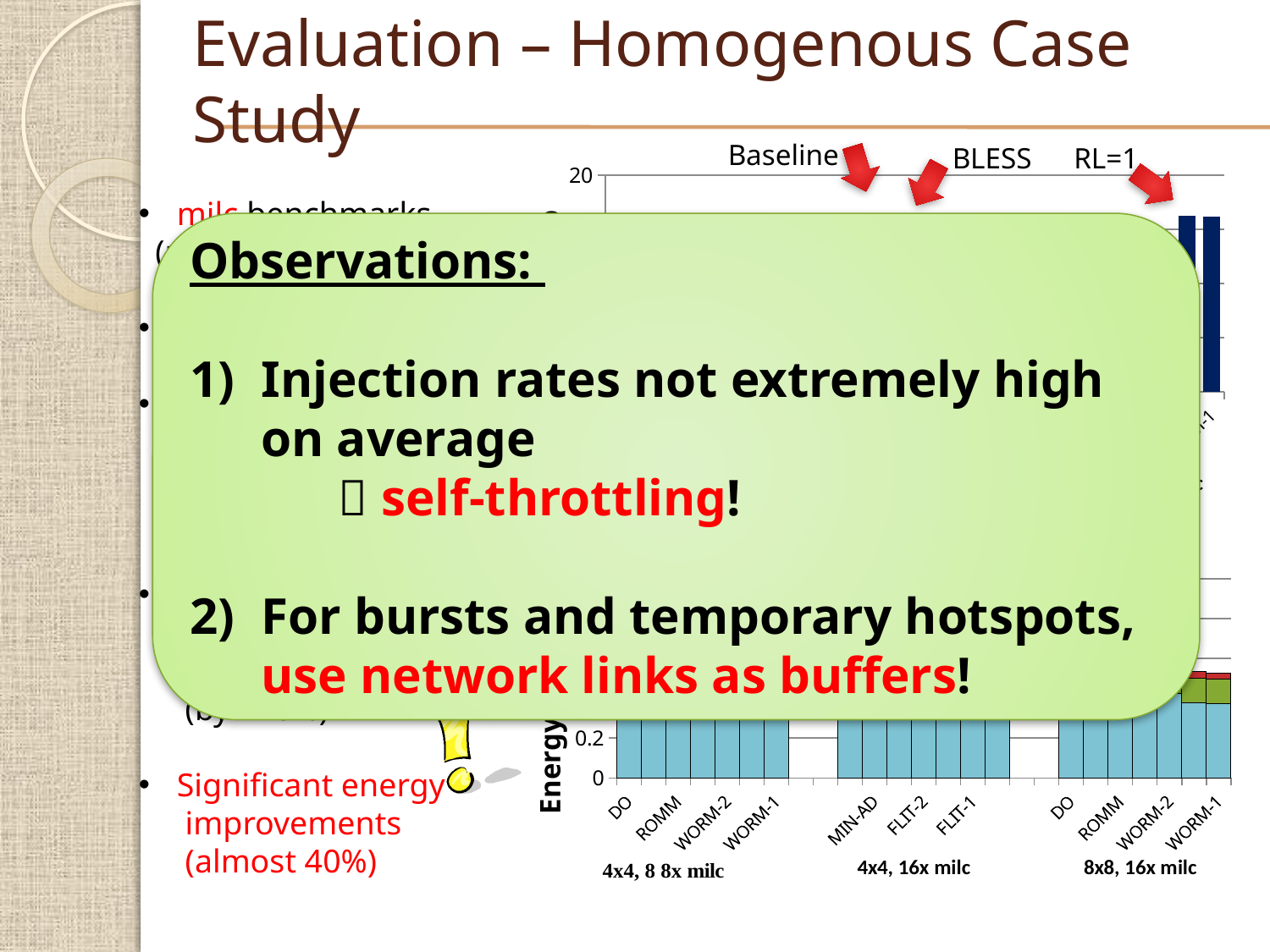
In the bottom chart, is the value for FLIT-1 greater or less than 0.2? greater What kind of chart is the bottom chart on the slide (the one with the Energy axis)? bar chart How many benchmark groups (group labels under the x axis) does the bottom chart show? 3 In the bottom chart, is the value for DO in the 4x4, 8 8x milc group greater or less than 0.2? greater In the bottom chart, which group label appears under the categories MIN-AD, FLIT-2 and FLIT-1? 4x4, 16x milc In the bottom chart, is the value for WORM-1 in the 8x8, 16x milc group greater or less than 0.2? greater How many category labels are shown along the x axis of the bottom chart? 11 What is the highest tick value visible on the vertical axis of the top chart? 20 What is the label on the vertical axis of the bottom chart? Energy